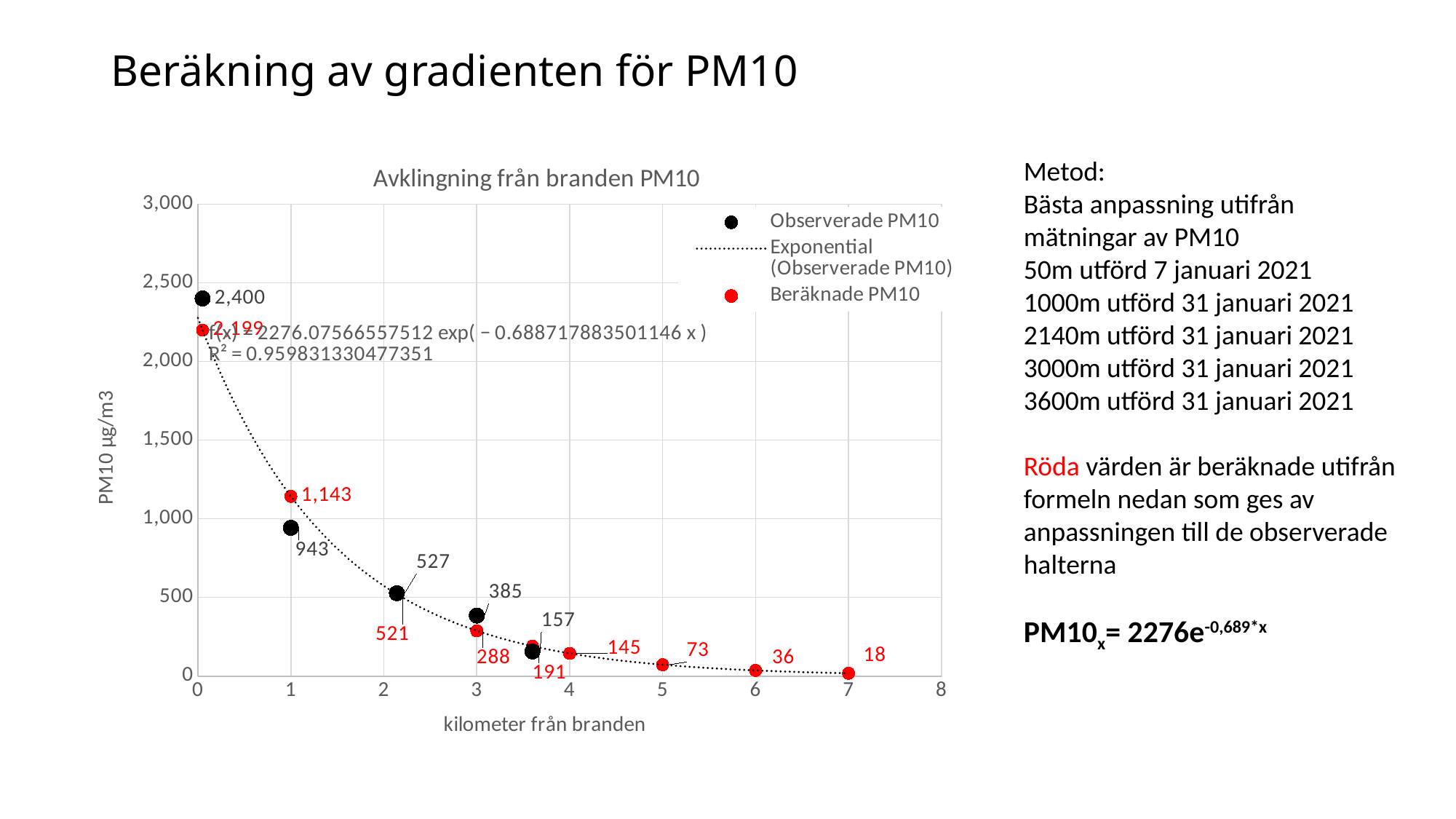
Do the PM10 values rise or fall as the distance from the fire increases? fall What is the highest labelled value in the Observerade PM10 series? 2,400 How many entries does the chart legend list? 3 Which is larger at 3 kilometer från branden: the Observerade PM10 value or the Beräknade PM10 value? Observerade PM10 What type of chart is shown on the slide? scatter chart What is the title of the chart? Avklingning från branden PM10 What is the difference between the Beräknade PM10 value at 1 km (1,143) and the Observerade PM10 value at 1 km (943)? 200 How many data points are plotted in the Beräknade PM10 series? 9 What is the lowest labelled value in the Beräknade PM10 series? 18 What is the Observerade PM10 value at 1 kilometer från branden? 943 What is the Beräknade PM10 value at 1 kilometer från branden? 1,143 What is the Beräknade PM10 value at 5 kilometer från branden? 73